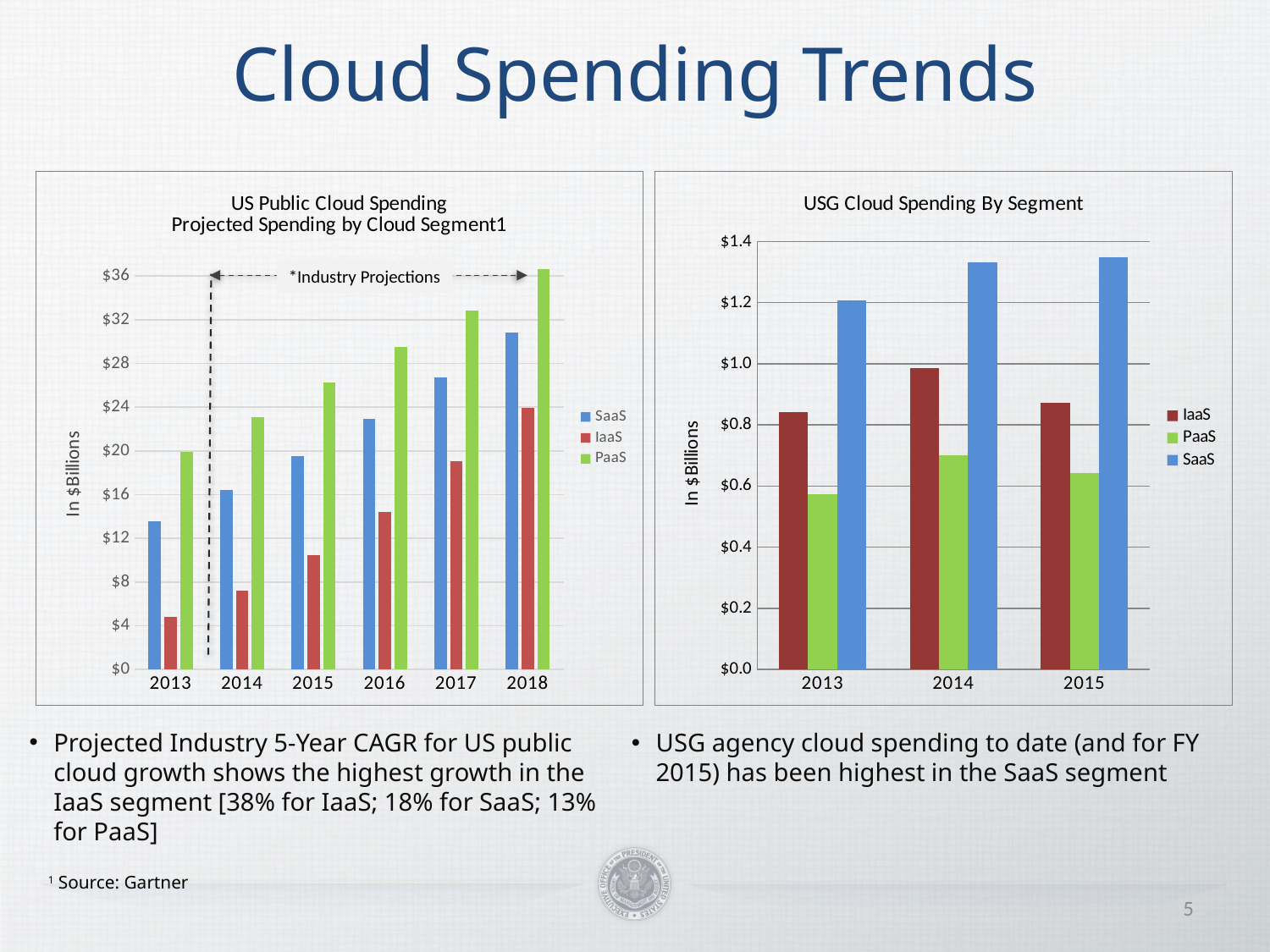
How many years are shown on the x axis of the 'US Public Cloud Spending' chart? 6 In the 'USG Cloud Spending By Segment' chart, which segment has the highest bar in 2014? SaaS In the 'USG Cloud Spending By Segment' chart, which segment has the lowest bar in 2015? PaaS How many series does the legend of the 'USG Cloud Spending By Segment' chart list? 3 In the 'USG Cloud Spending By Segment' chart, which is larger: IaaS in 2014 or IaaS in 2013? IaaS in 2014 What kind of chart is the 'US Public Cloud Spending' chart? bar chart In the 'US Public Cloud Spending' chart, is the PaaS value for 2016 greater or less than $28? greater In the 'US Public Cloud Spending' chart, which segment has the lowest bar in 2013? IaaS In the 'US Public Cloud Spending' chart, does IaaS spending rise or fall from 2013 to 2018? rise In the 'US Public Cloud Spending' chart, which segment has the highest bar in 2018? PaaS In the 'US Public Cloud Spending' chart, is the IaaS value for 2014 greater or less than $8? less In the 'USG Cloud Spending By Segment' chart, is the IaaS value for 2014 greater or less than $0.8? greater